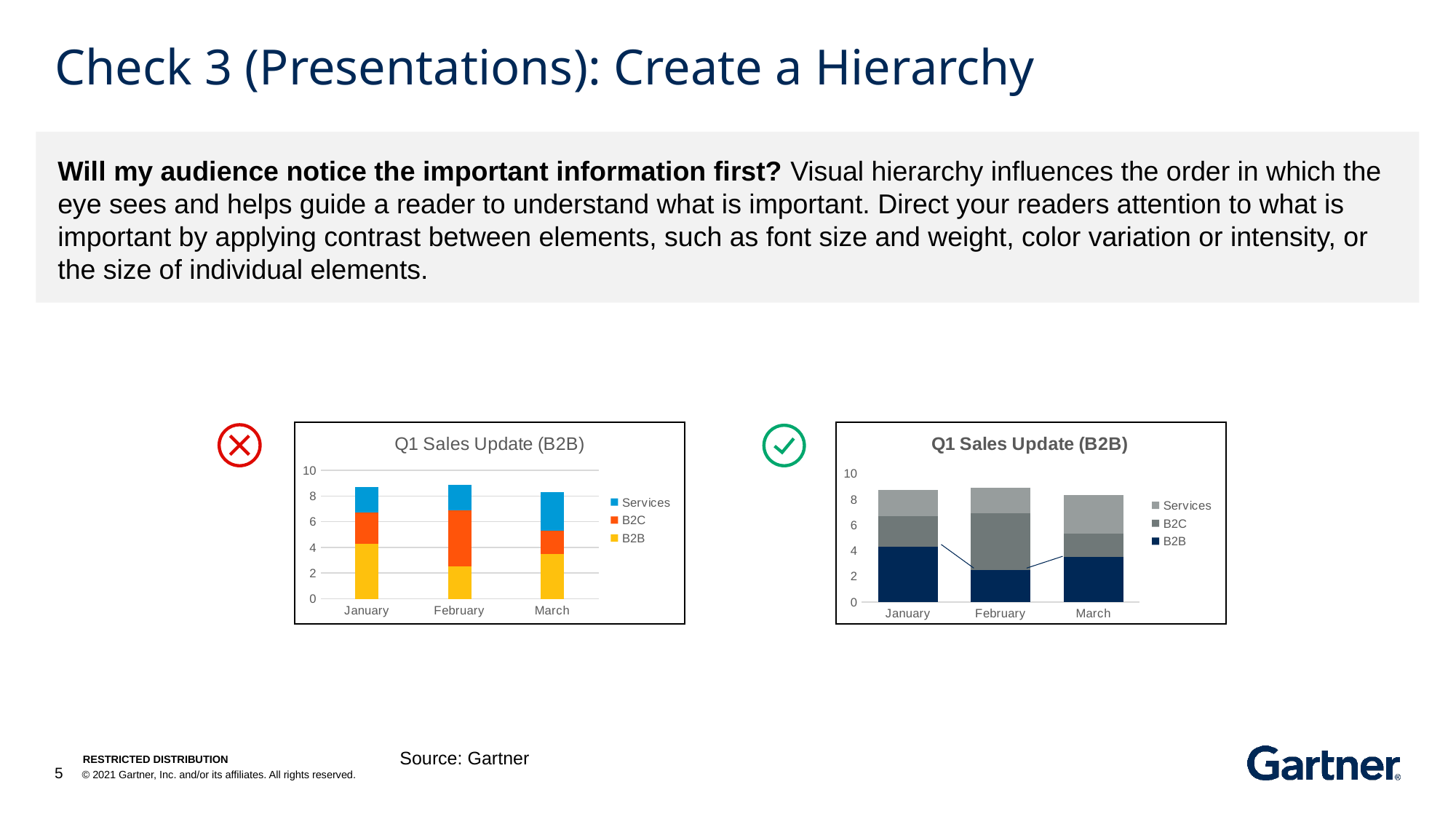
How many categories are shown on the x axis of the left chart? 3 In the right chart, which series is shown in the darkest (navy) colour? B2B What is the title of the right chart? Q1 Sales Update (B2B) In the left chart, is the B2B value for February greater or less than 4? less How many series does the legend of the right chart (marked with the green check) list? 3 In the left chart, which month has the highest B2B value? January What kind of chart is the left chart (marked with the red X)? Stacked bar chart In the right chart, which month has the highest Services value? March In the left chart, which is larger: the B2C value for February or the B2C value for March? February In the right chart, is the total stacked value for February greater or less than 8? greater In the left chart, which month has the highest B2C value? February In the right chart, which month has the lowest B2B value? February